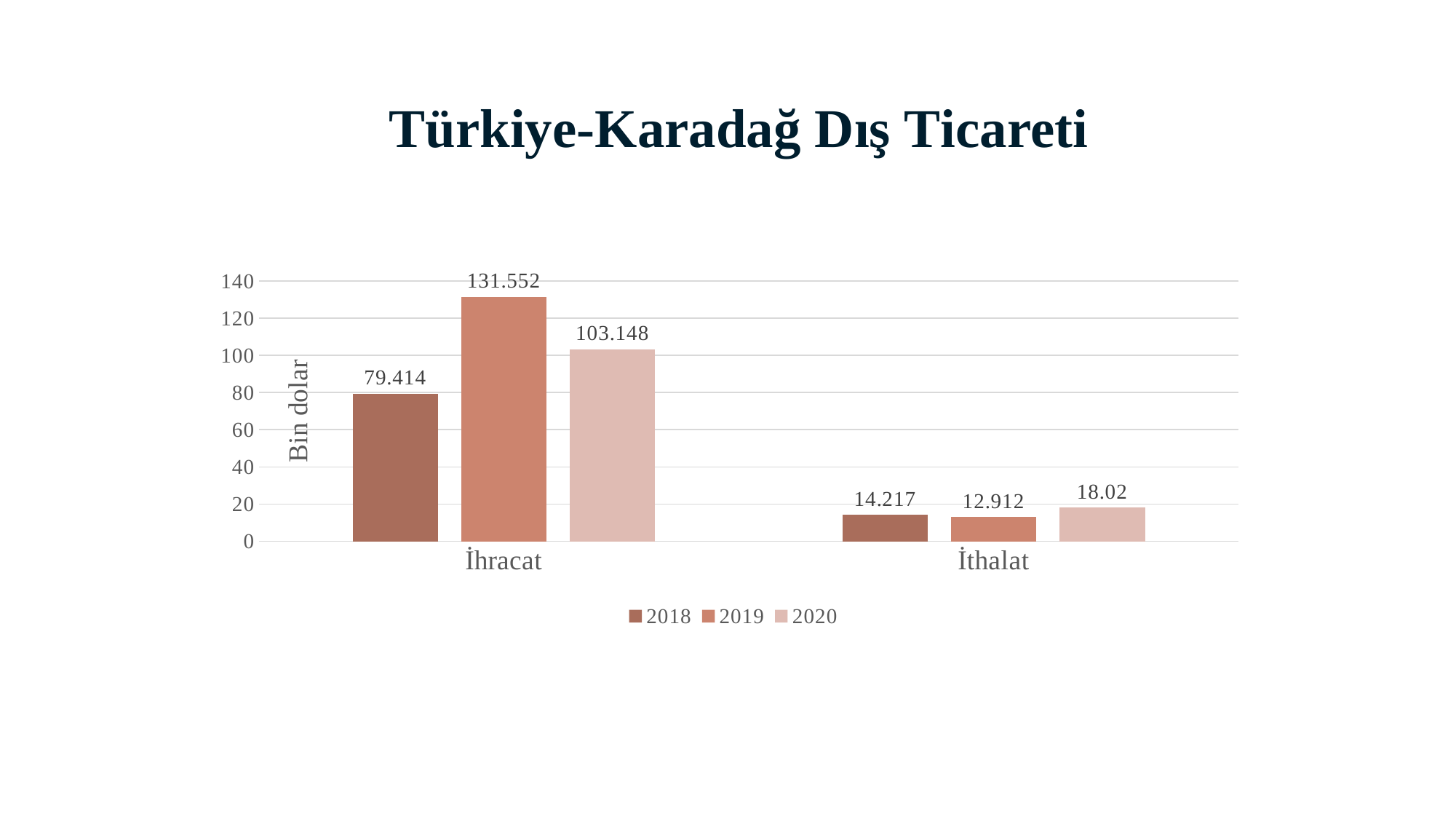
How many categories are shown on the x axis? 2 What is the value for İthalat in 2020? 18.02 Which year has the highest İhracat value? 2019 What is the difference between the İhracat values for 2019 and 2018? 52.138 What is the value for İhracat in 2019? 131.552 What is the title of the chart? Türkiye-Karadağ Dış Ticareti Which year has the lowest İthalat value? 2019 How many series does the legend list? 3 What is the value for İhracat in 2018? 79.414 What kind of chart is shown on the slide? Bar chart Which is larger, İhracat in 2020 or İhracat in 2018? İhracat in 2020 What is the difference between the İthalat values for 2020 and 2019? 5.108